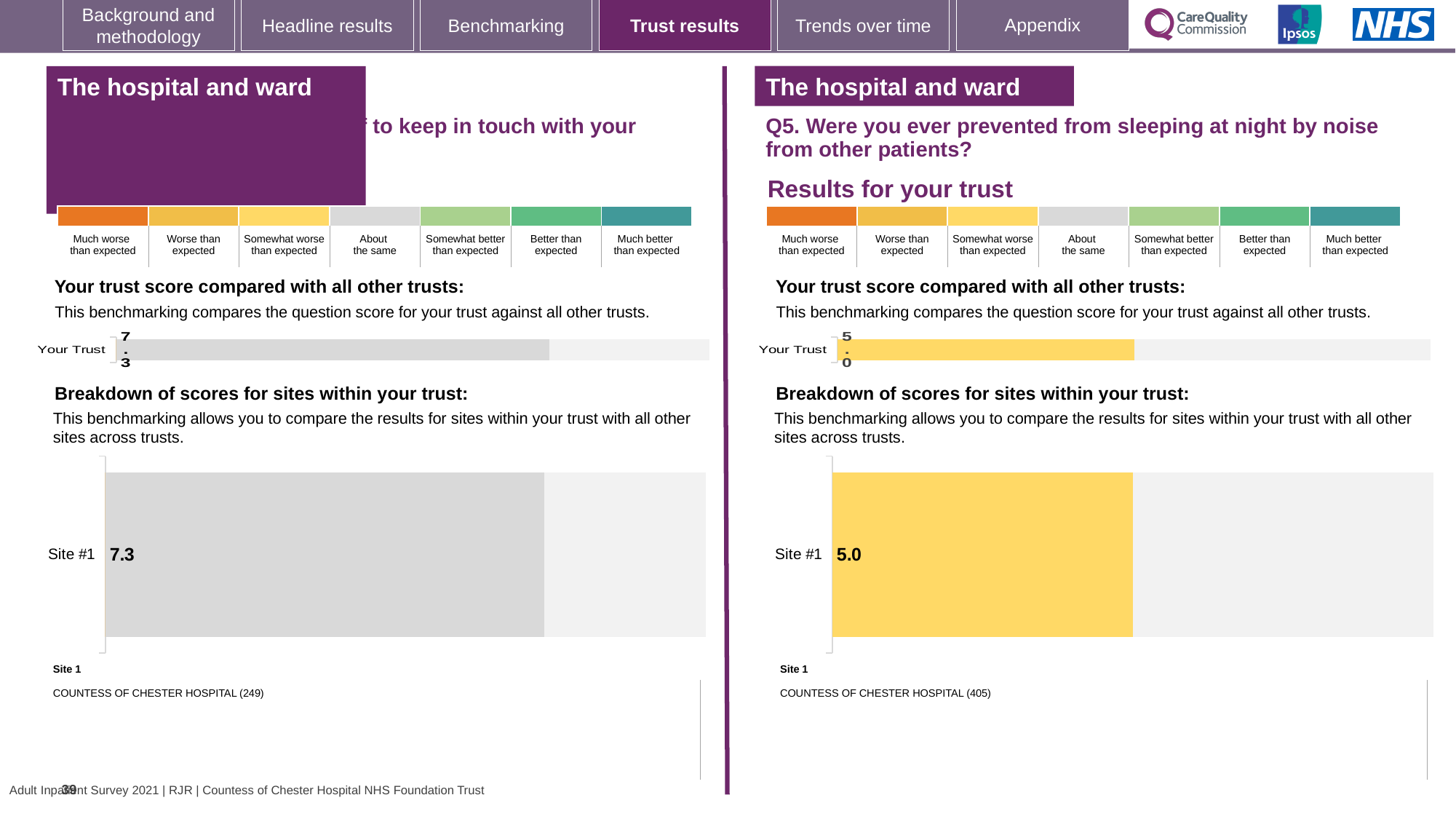
Which Site #1 score is larger: the one on the left-hand chart or the one on the right-hand Q5 chart? The left-hand chart (7.3) On the left-hand chart, which benchmark category does the grey colour of the Your Trust bar correspond to in the key? About the same On the right-hand Q5 chart, which benchmark category does the yellow colour of the Your Trust bar correspond to in the key? Somewhat worse than expected On the right-hand chart for Q5 (prevented from sleeping at night by noise from other patients), what is the score shown for Your Trust? 5.0 On the left-hand breakdown chart of scores for sites within your trust, what is the score for Site #1? 7.3 On the left-hand chart (the question about keeping in touch), what is the score shown for Your Trust? 7.3 On the left-hand breakdown chart, which hospital is listed as Site 1? COUNTESS OF CHESTER HOSPITAL (249) On the right-hand Q5 breakdown chart of scores for sites within your trust, what is the score for Site #1? 5.0 What is the difference between the Site #1 score on the left-hand chart and the Site #1 score on the right-hand Q5 chart? 2.3 On the right-hand Q5 breakdown chart, which hospital is listed as Site 1? COUNTESS OF CHESTER HOSPITAL (405) What kind of chart is used to show the Site #1 score on the right-hand Q5 breakdown? Bar chart How many sites are shown in the right-hand Q5 breakdown of scores for sites within your trust? 1